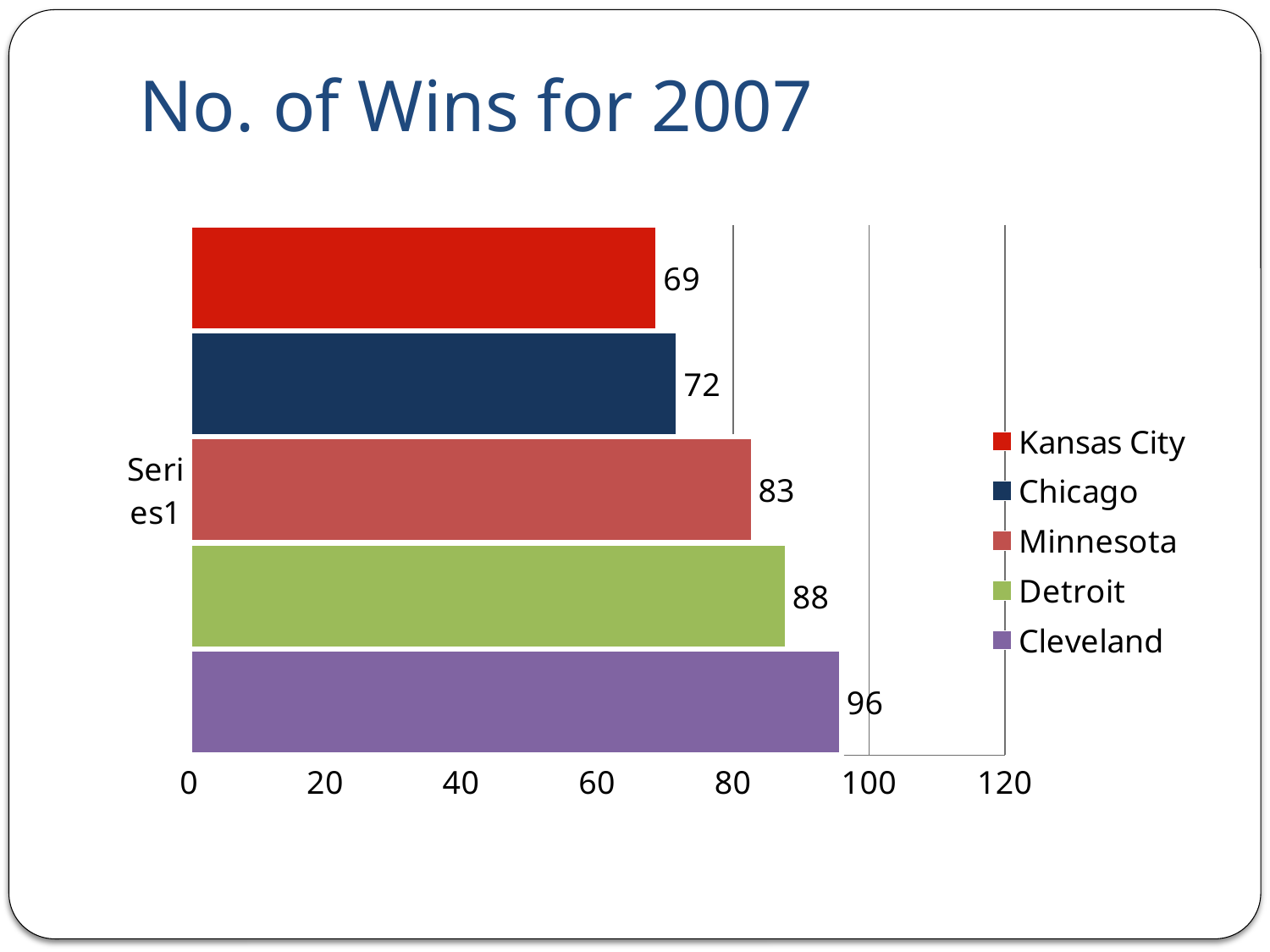
What is the number of wins for Minnesota? 83 How many teams are shown in the chart? 5 What is the difference in wins between Cleveland and Kansas City? 27 What is the title of the chart? No. of Wins for 2007 What kind of chart is shown on the slide? bar chart What is the number of wins for Cleveland? 96 Which team has the lowest number of wins? Kansas City Is the value for Detroit greater or less than 100? less What is the difference in wins between Detroit and Chicago? 16 What is the number of wins for Kansas City? 69 Which team has the highest number of wins? Cleveland Which has more wins, Minnesota or Chicago? Minnesota